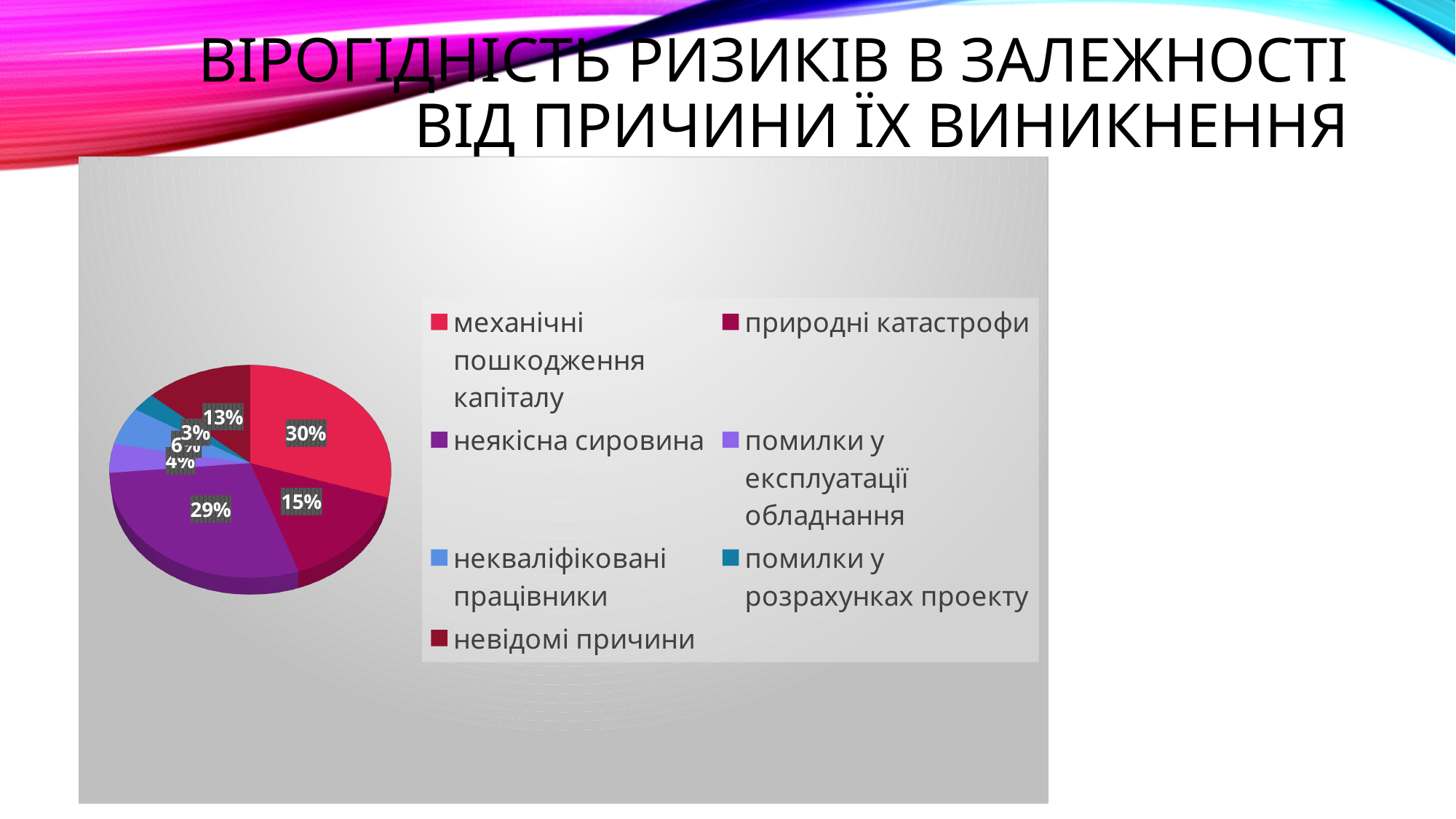
What kind of chart is shown on the slide? pie chart Which category has the smallest share of the pie? помилки у розрахунках проекту What share of the pie is природні катастрофи? 15% What is the difference between the shares of механічні пошкодження капіталу and природні катастрофи? 15% What share of the pie is неякісна сировина? 29% What share of the pie is механічні пошкодження капіталу? 30% Which is larger: the share of природні катастрофи or the share of невідомі причини? природні катастрофи How many categories does the pie chart have? 7 What share of the pie is помилки у розрахунках проекту? 3% What share of the pie is невідомі причини? 13% What is the title of the slide containing the chart? Вірогідність ризиків в залежності від причини їх виникнення Which category has the largest share of the pie? механічні пошкодження капіталу